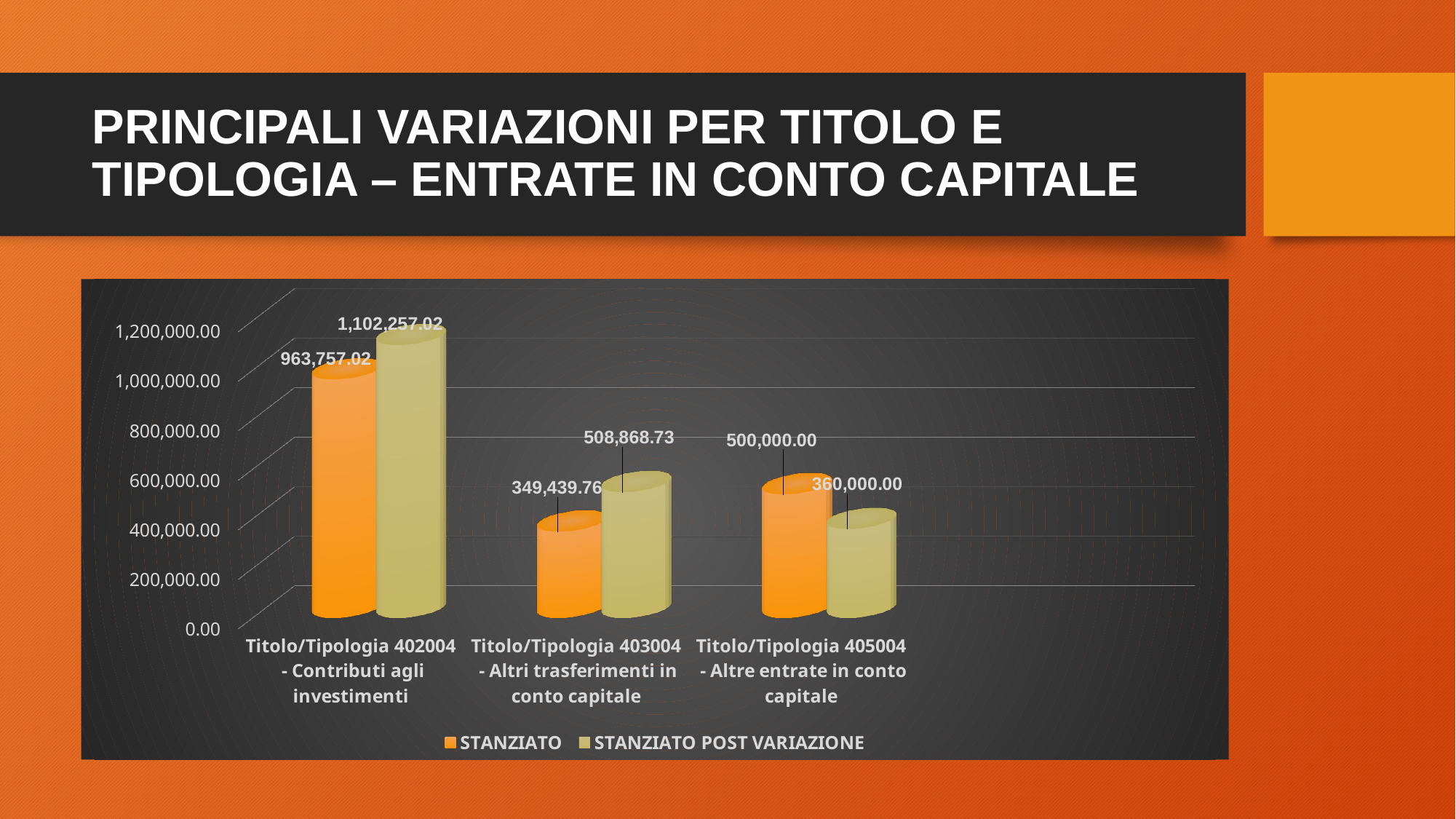
What is the STANZIATO POST VARIAZIONE value for Titolo/Tipologia 402004 - Contributi agli investimenti? 1,102,257.02 What is the difference between the STANZIATO POST VARIAZIONE and STANZIATO values for Titolo/Tipologia 402004 - Contributi agli investimenti? 138,500.00 What is the STANZIATO value for Titolo/Tipologia 402004 - Contributi agli investimenti? 963,757.02 How many series does the legend list? 2 Which category has the lowest STANZIATO value? Titolo/Tipologia 403004 - Altri trasferimenti in conto capitale How many categories are shown on the x axis? 3 What is the STANZIATO POST VARIAZIONE value for Titolo/Tipologia 403004 - Altri trasferimenti in conto capitale? 508,868.73 Which category has the highest STANZIATO POST VARIAZIONE value? Titolo/Tipologia 402004 - Contributi agli investimenti What is the STANZIATO value for Titolo/Tipologia 405004 - Altre entrate in conto capitale? 500,000.00 For Titolo/Tipologia 405004 - Altre entrate in conto capitale, which is larger: STANZIATO or STANZIATO POST VARIAZIONE? STANZIATO What kind of chart is shown on the slide? Bar chart What is the difference between the STANZIATO and STANZIATO POST VARIAZIONE values for Titolo/Tipologia 405004 - Altre entrate in conto capitale? 140,000.00